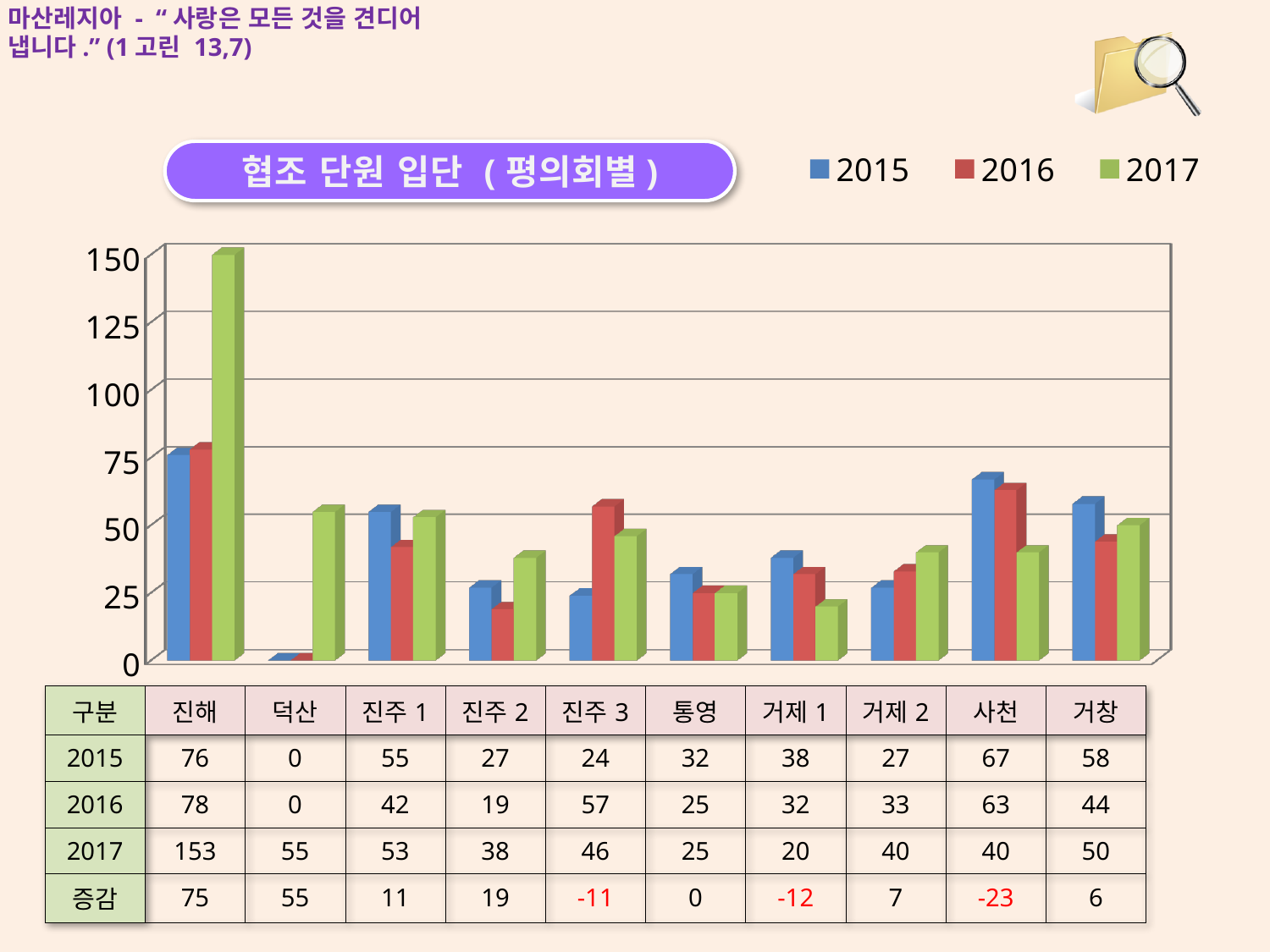
Which category has the highest 2017 value? 진해 Which category has the lowest 2015 value? 덕산 What is the difference between the 2017 and 2015 values for 진해? 77 Is the 2017 value for 진해 greater or less than 125? greater What is the title of the chart? 협조 단원 입단 ( 평의회별 ) What is the 2017 value for 진해? 153 How many categories (평의회) are shown along the x axis of the chart? 10 Which is larger for 거제 1: the 2015 value or the 2017 value? 2015 What is the 2015 value for 사천? 67 What type of chart is shown on the slide? bar chart How many series does the chart legend list? 3 What is the 2016 value for 진주 3? 57